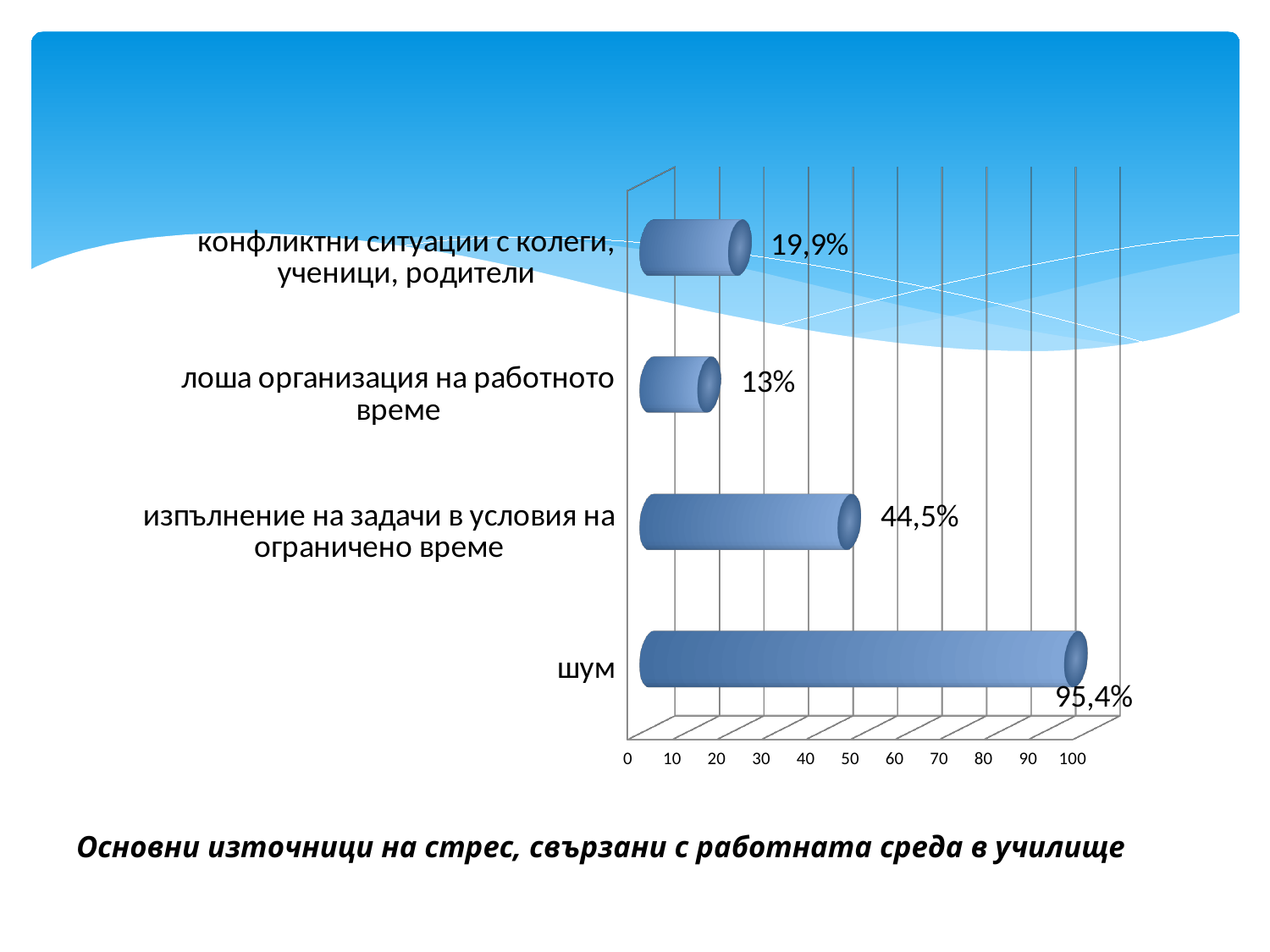
Which category has the highest value? шум What is the value for "шум"? 95,4% What is the value for "лоша организация на работното време"? 13% Is the value for "изпълнение на задачи в условия на ограничено време" greater or less than 50? less Which category has the lowest value? лоша организация на работното време Which is larger: the value for "конфликтни ситуации с колеги, ученици, родители" or the value for "лоша организация на работното време"? конфликтни ситуации с колеги, ученици, родители What is the title text shown below the chart? Основни източници на стрес, свързани с работната среда в училище How many categories are shown in the chart? 4 What is the value for "конфликтни ситуации с колеги, ученици, родители"? 19,9% What is the difference between the values for "шум" and "изпълнение на задачи в условия на ограничено време"? 50,9% What kind of chart is shown on the slide? bar chart What is the value for "изпълнение на задачи в условия на ограничено време"? 44,5%